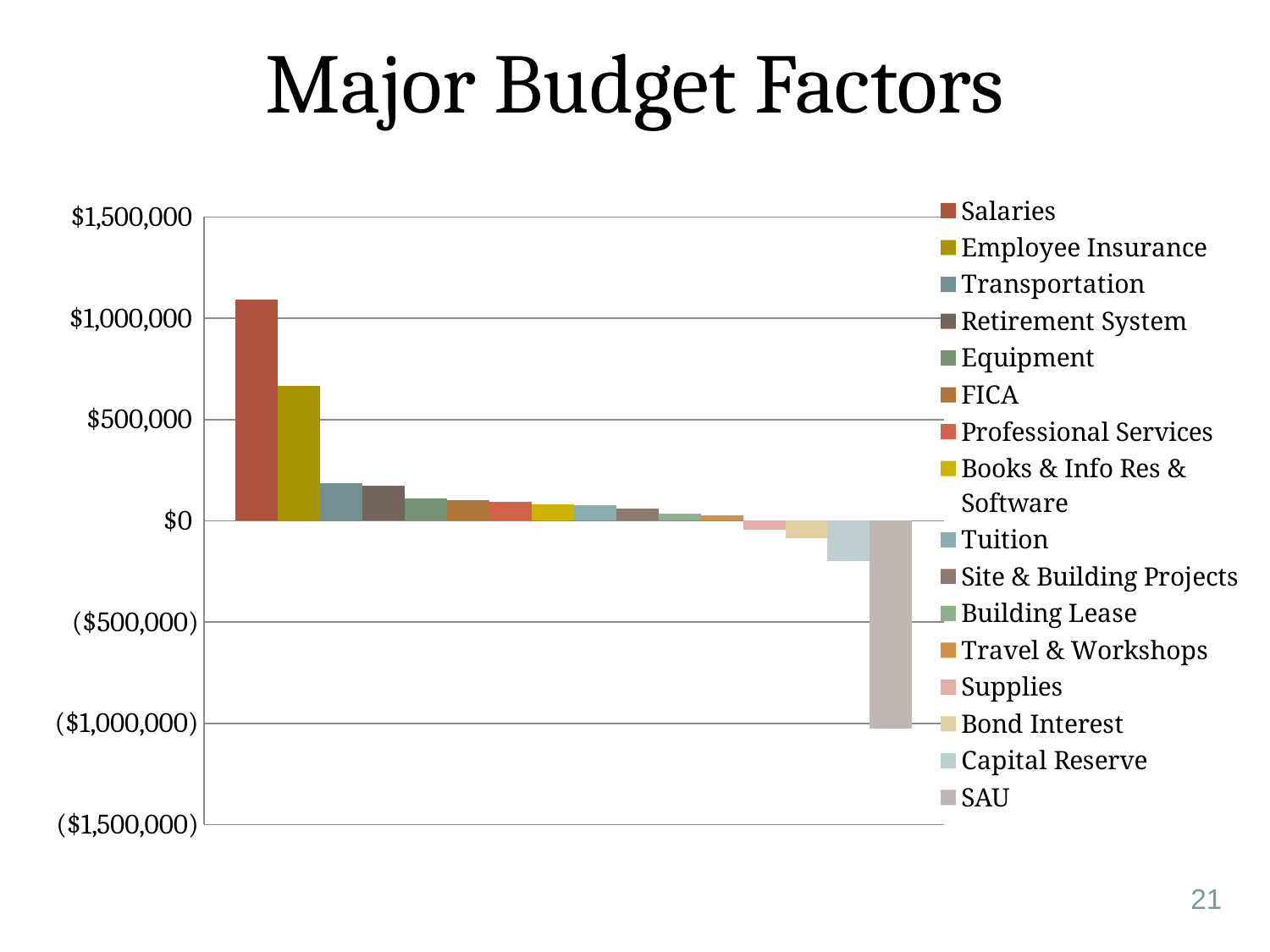
Which is larger, the value for Salaries or the value for Employee Insurance? Salaries Is the value for Employee Insurance greater or less than $500,000? greater Which series is listed last in the legend? SAU Is the value for Capital Reserve greater or less than $0? less Which budget factor has the lowest value? SAU Is the value for Transportation greater or less than $500,000? less How many series does the legend list? 16 What is the title of the slide containing the chart? Major Budget Factors Which budget factor has the highest value? Salaries Which is larger, the value for Transportation or the value for Employee Insurance? Employee Insurance What kind of chart is shown on the slide? bar chart